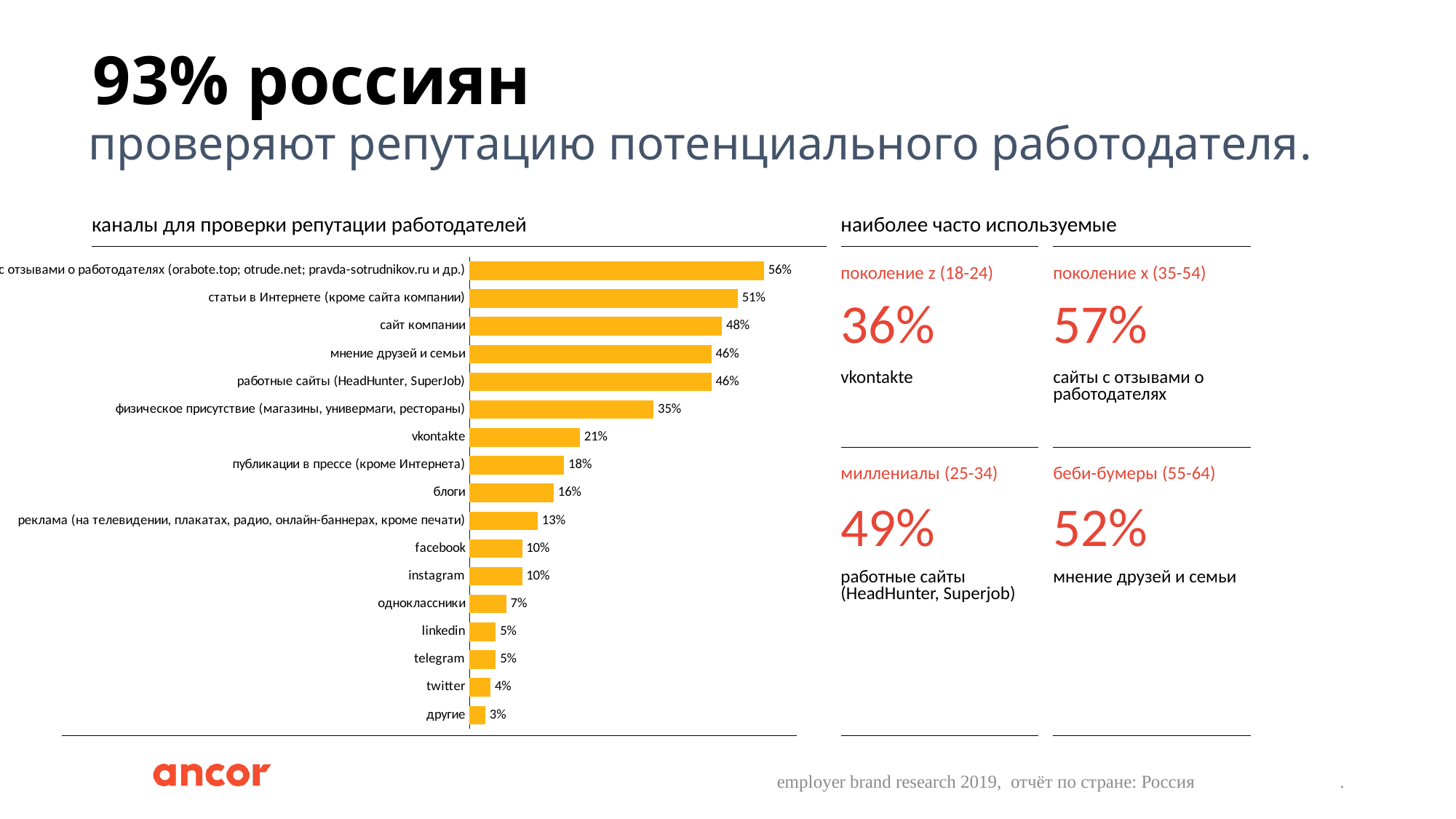
What is the value for одноклассники? 7% What is the value for физическое присутствие (магазины, универмаги, рестораны)? 35% What is the value for сайт компании? 48% Which channel has the highest value in the bar chart? сайты с отзывами о работодателях What is the title of the bar chart? каналы для проверки репутации работодателей What kind of chart is shown on the slide? bar chart How many categories (channels) are plotted in the bar chart? 17 Do the bar values increase or decrease going from the top of the chart to the bottom? decrease Which channel has the lowest value in the bar chart? другие What is the value for vkontakte in the bar chart? 21% What is the difference between the values for статьи в Интернете (кроме сайта компании) and блоги? 35% Which has a larger value, публикации в прессе (кроме Интернета) or реклама (на телевидении, плакатах, радио, онлайн-баннерах, кроме печати)? публикации в прессе (кроме Интернета)